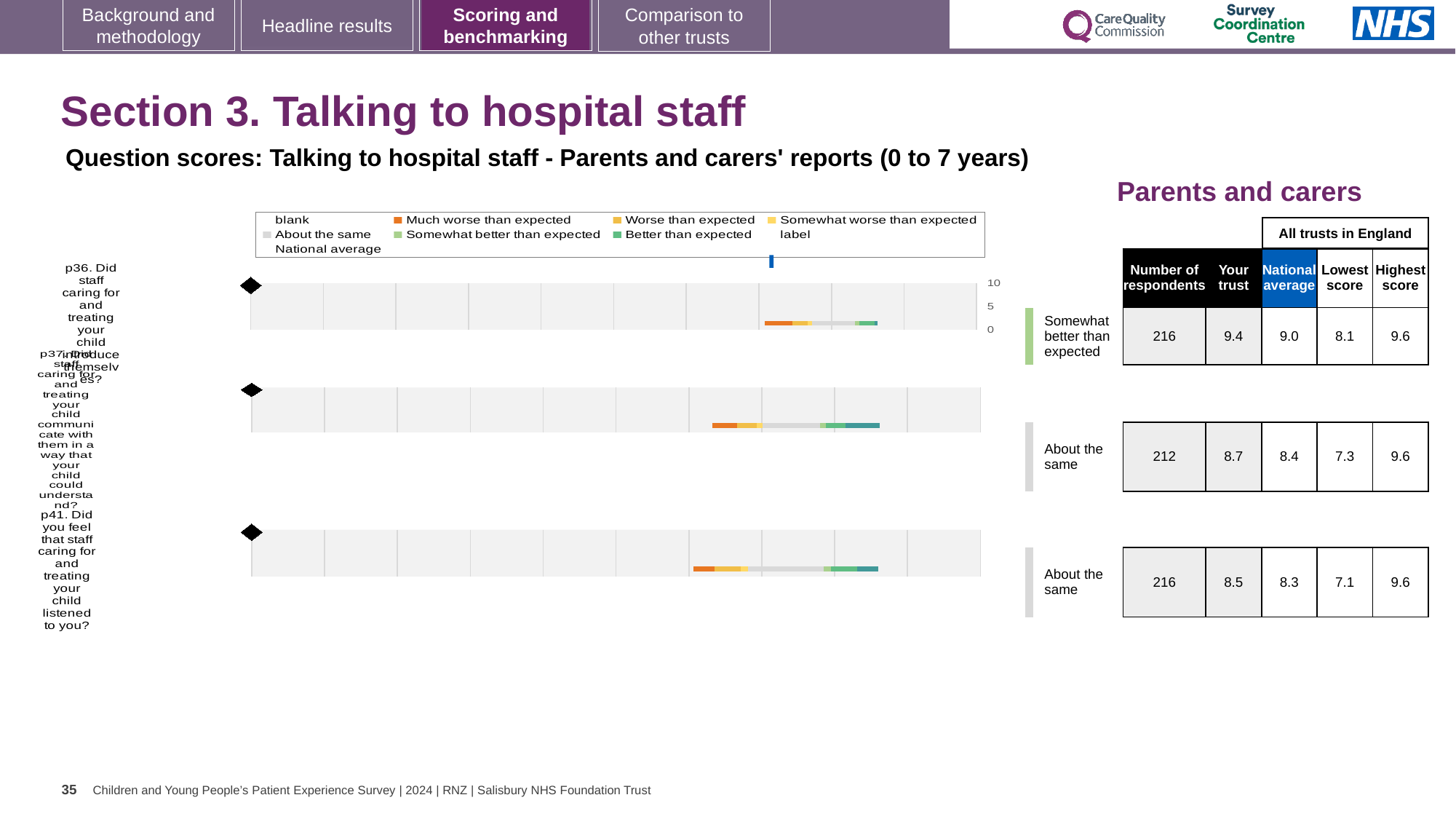
In the table beside the chart, how many respondents answered p37 (the second bar)? 212 Which benchmark category is shown beside the bar for p36 (Did staff caring for and treating your child introduce themselves)? Somewhat better than expected What is the highest tick value shown on the chart's axis? 10 Which benchmark category is shown beside the bar for p41 (Did you feel that staff caring for and treating your child listened to you)? About the same What colour does the legend use for 'Much worse than expected'? orange Which benchmark category is shown beside the bar for p37 (Did staff communicate with them in a way that your child could understand)? About the same How many entries does the chart legend list? 9 What kind of chart is shown on the slide? bar chart In the table beside the chart, what is the national average for p41 (the third bar)? 8.3 In the table beside the chart, which of the three questions has the highest 'Your trust' score? p36 In the table beside the chart, what is the 'Your trust' score for p36 (the first bar)? 9.4 How many survey questions (bars) are plotted in the chart? 3